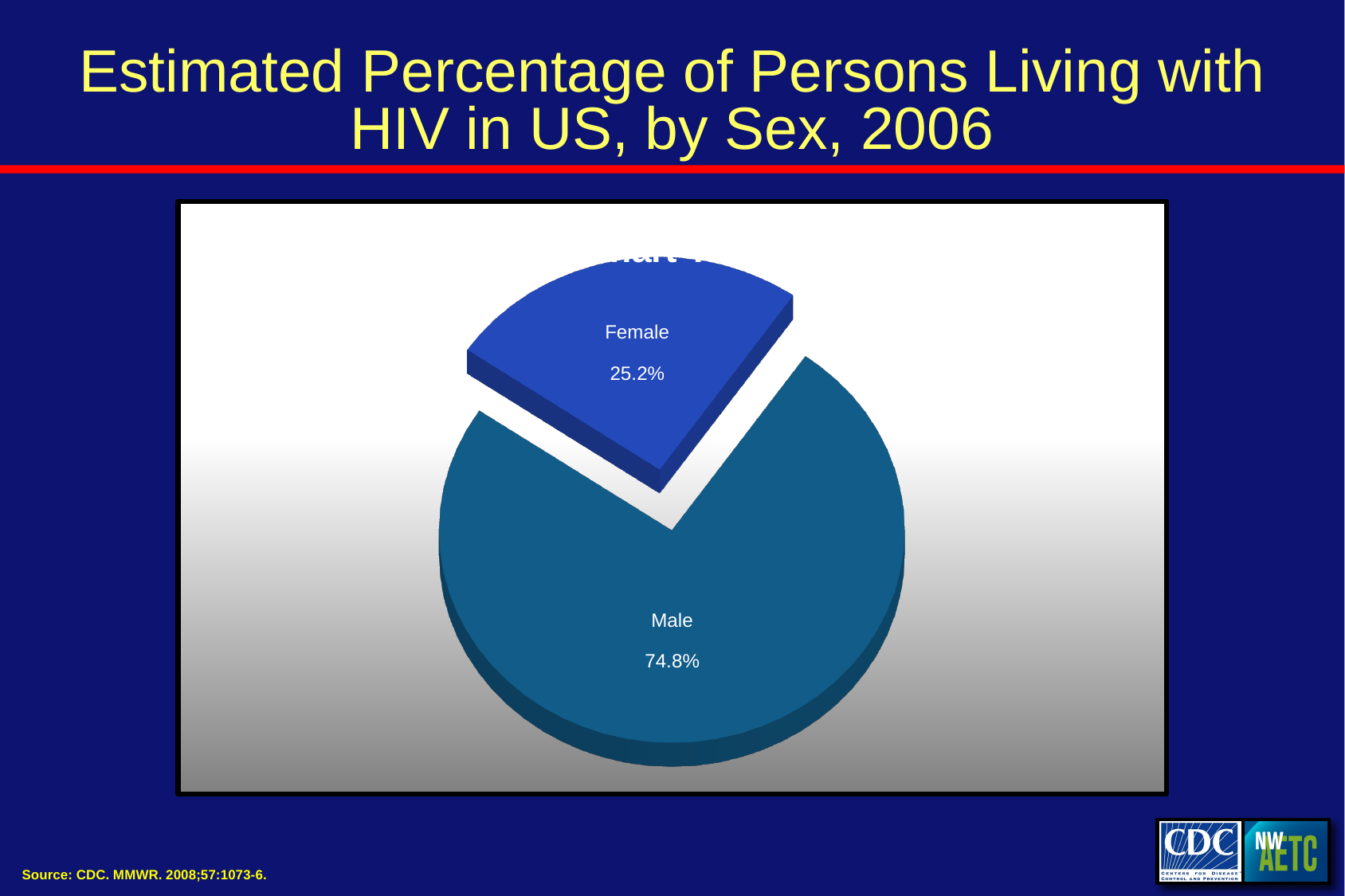
What percentage of persons living with HIV in the US in 2006 were male, according to the pie chart? 74.8% Which sex accounts for the smallest slice of the pie chart? Female What is the share of the pie represented by the Female slice? 25.2% What percentage of persons living with HIV in the US in 2006 were female, according to the pie chart? 25.2% Is the Male share greater or less than 50%? greater What is the difference in percentage points between the Male and Female slices? 49.6 Which slice is pulled out (exploded) from the rest of the pie? Female What type of chart is shown on the slide? Pie chart Which sex accounts for the largest slice of the pie chart? Male How many slices does the pie chart have? 2 What is the title of the slide containing the pie chart? Estimated Percentage of Persons Living with HIV in US, by Sex, 2006 Which slice is larger, Male or Female? Male